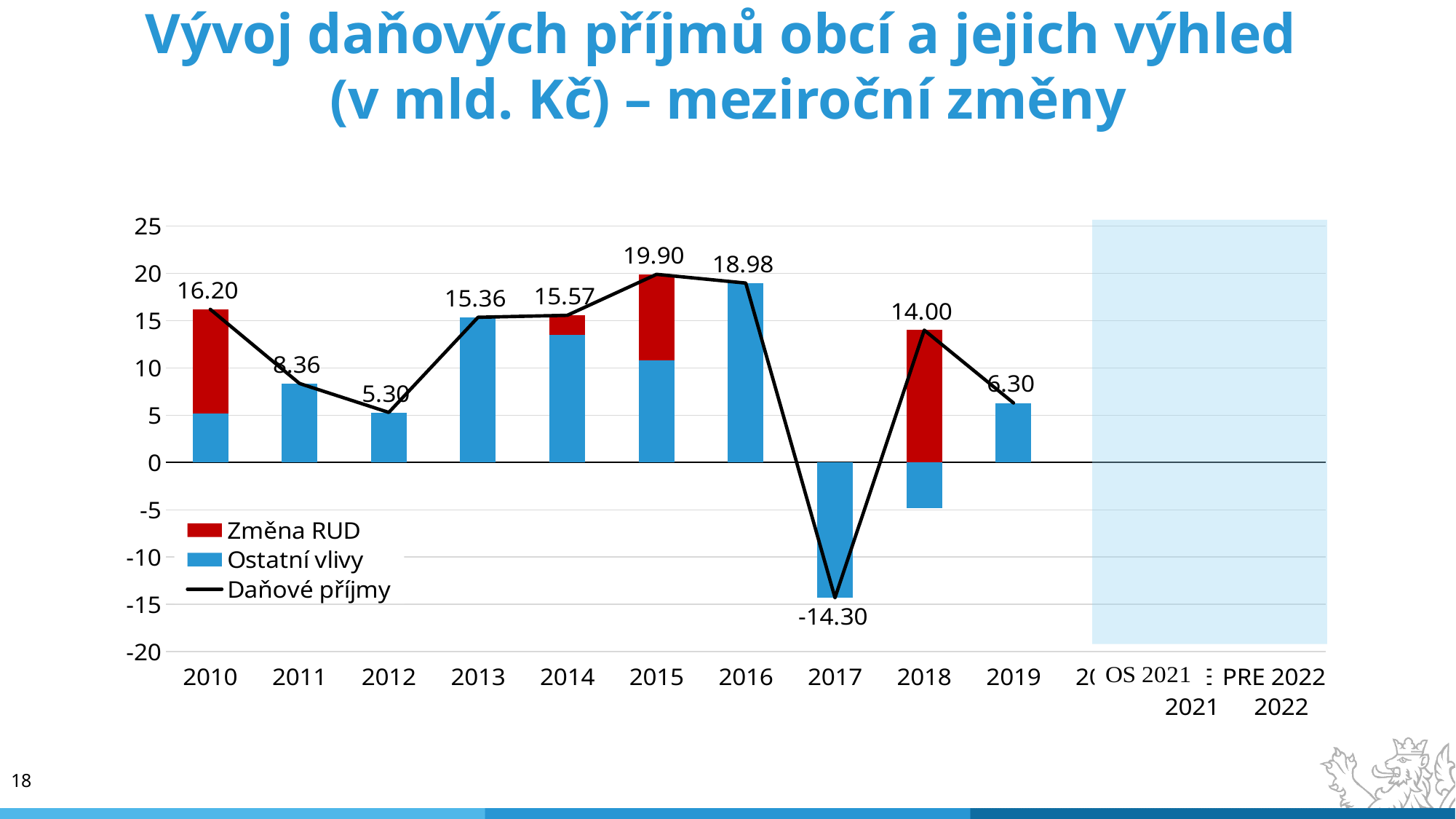
Is the Ostatní vlivy bar for 2016 greater or less than 15? greater What is the value of Daňové příjmy for 2015? 19.90 What is the difference between the Daňové příjmy values for 2015 and 2016? 0.92 What is the value of Daňové příjmy for 2019? 6.30 What is the value of Daňové příjmy for 2011? 8.36 Which year has the highest labelled value of Daňové příjmy? 2015 Which series is shown in red? Změna RUD How many series does the legend list? 3 Which is larger, the Daňové příjmy value for 2010 or for 2018? 2010 Do the Daňové příjmy values rise or fall from 2010 to 2012? fall What is the value of Daňové příjmy for 2017? -14.30 Which year has the lowest labelled value of Daňové příjmy? 2017